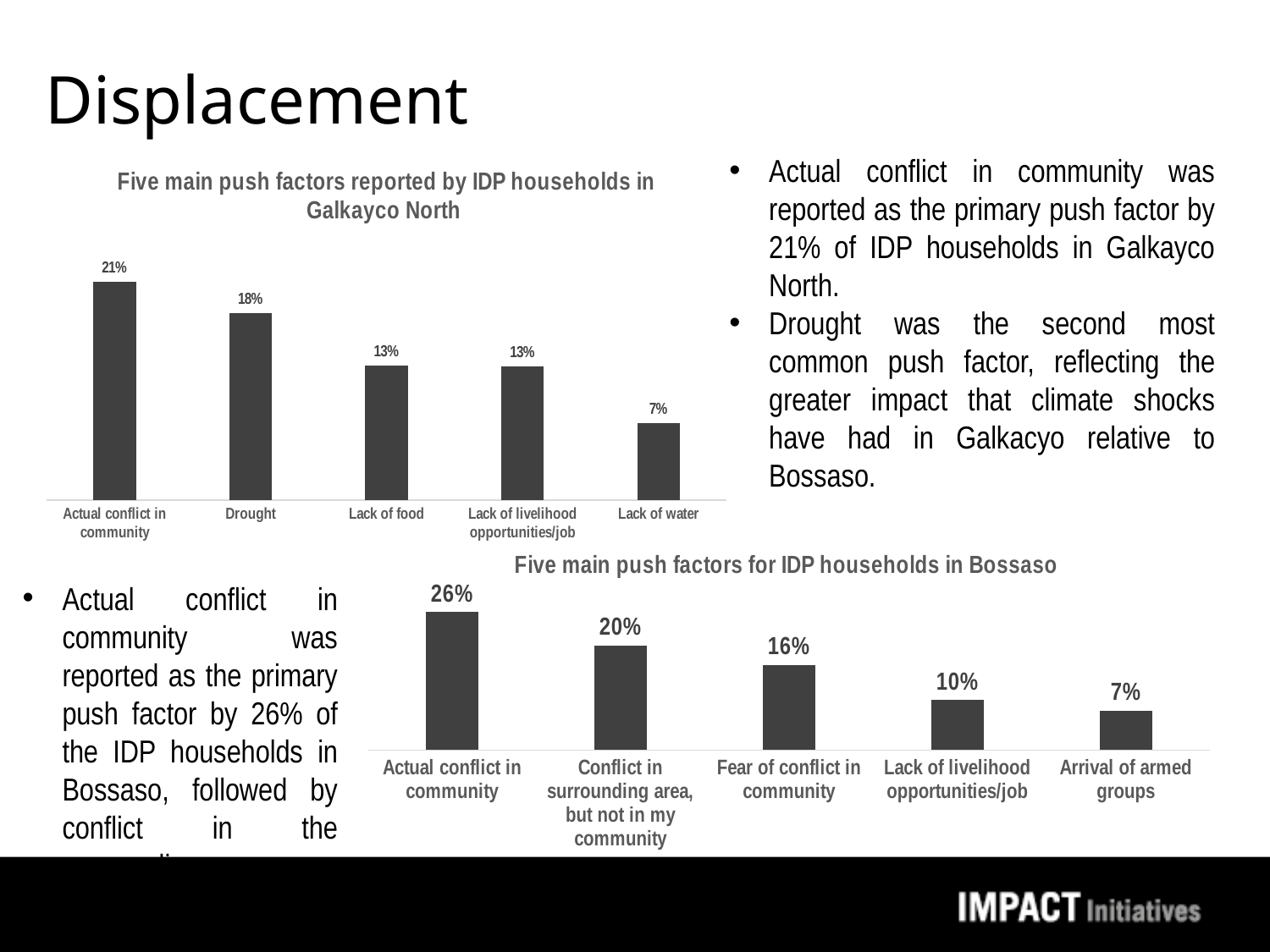
In the 'Five main push factors reported by IDP households in Galkayco North' chart, what is the value for Drought? 18% In the 'Five main push factors for IDP households in Bossaso' chart, what is the value for Lack of livelihood opportunities/job? 10% In the 'Five main push factors for IDP households in Bossaso' chart, what is the value for Fear of conflict in community? 16% Which is larger: Actual conflict in community in the Galkayco North chart or Actual conflict in community in the Bossaso chart? Bossaso chart In the 'Five main push factors reported by IDP households in Galkayco North' chart, what is the difference between Actual conflict in community and Lack of water? 14% In the 'Five main push factors reported by IDP households in Galkayco North' chart, which category has the highest value? Actual conflict in community In the 'Five main push factors for IDP households in Bossaso' chart, what is the difference between Actual conflict in community and Conflict in surrounding area, but not in my community? 6% What type of chart is the 'Five main push factors for IDP households in Bossaso' chart? Bar chart In the 'Five main push factors for IDP households in Bossaso' chart, which category has the lowest value? Arrival of armed groups In the 'Five main push factors for IDP households in Bossaso' chart, which category has the highest value? Actual conflict in community In the 'Five main push factors reported by IDP households in Galkayco North' chart, which category has the lowest value? Lack of water In the 'Five main push factors reported by IDP households in Galkayco North' chart, how many categories are shown? 5